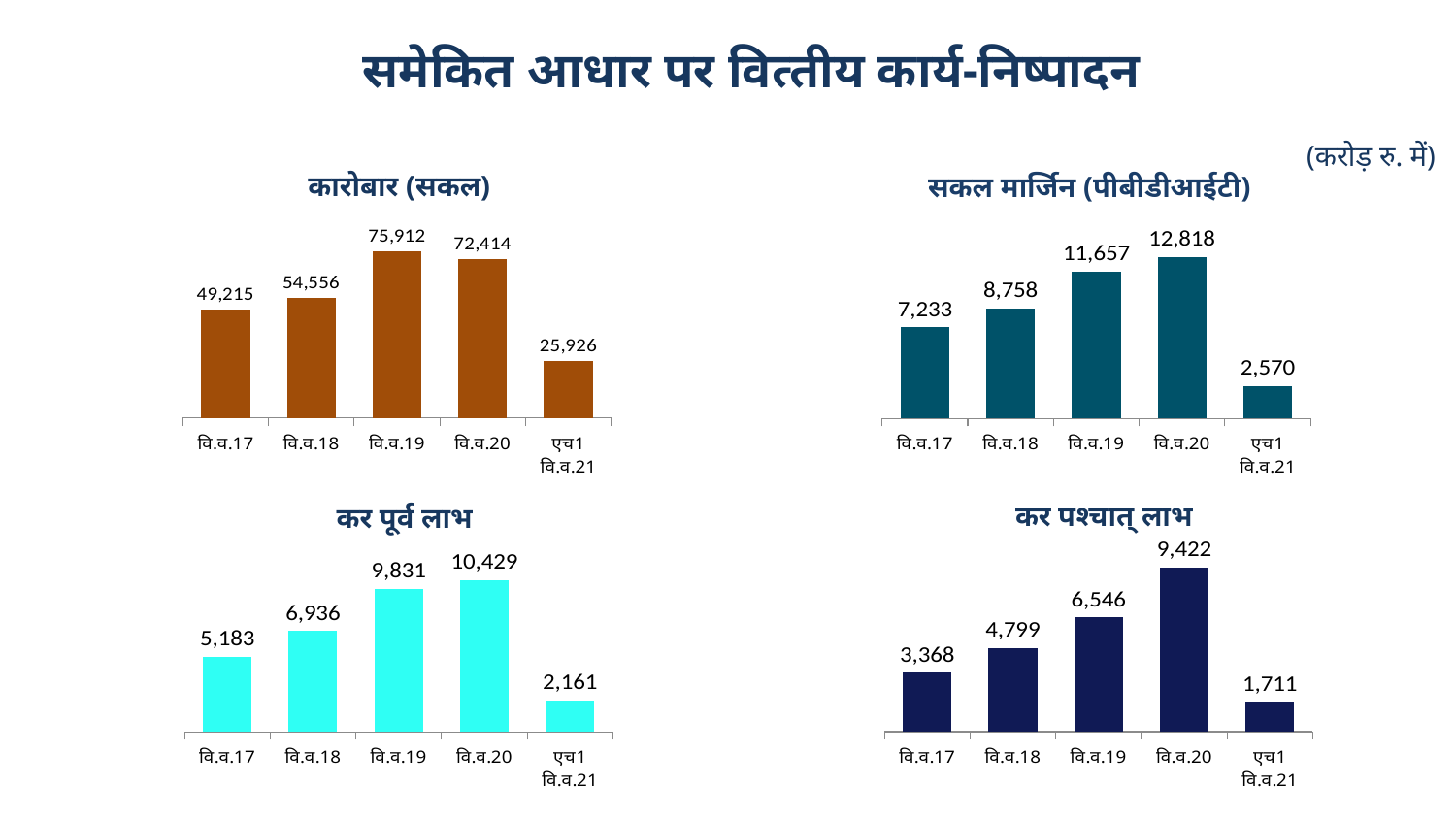
In the top-right chart titled "सकल मार्जिन (पीबीडीआईटी)", do the values rise or fall from वि.व.17 to वि.व.20? Rise What kind of chart is the top-right chart titled "सकल मार्जिन (पीबीडीआईटी)"? Bar chart In the bottom-right chart titled "कर पश्चात् लाभ", which is larger, the value for वि.व.19 or वि.व.20? वि.व.20 In the top-left chart titled "कारोबार (सकल)", what is the value for वि.व.19? 75,912 How many categories are shown on the x axis of the top-left chart titled "कारोबार (सकल)"? 5 In the top-right chart titled "सकल मार्जिन (पीबीडीआईटी)", which category has the lowest value? एच1 वि.व.21 In the top-right chart titled "सकल मार्जिन (पीबीडीआईटी)", what is the value for वि.व.20? 12,818 In the top-left chart titled "कारोबार (सकल)", which category has the highest value? वि.व.19 In the bottom-left chart titled "कर पूर्व लाभ", what is the difference between the values for वि.व.20 and वि.व.19? 598 In the bottom-right chart titled "कर पश्चात् लाभ", what is the value for वि.व.17? 3,368 In the bottom-left chart titled "कर पूर्व लाभ", what is the value for वि.व.18? 6,936 In the bottom-right chart titled "कर पश्चात् लाभ", what is the difference between the values for वि.व.20 and एच1 वि.व.21? 7,711